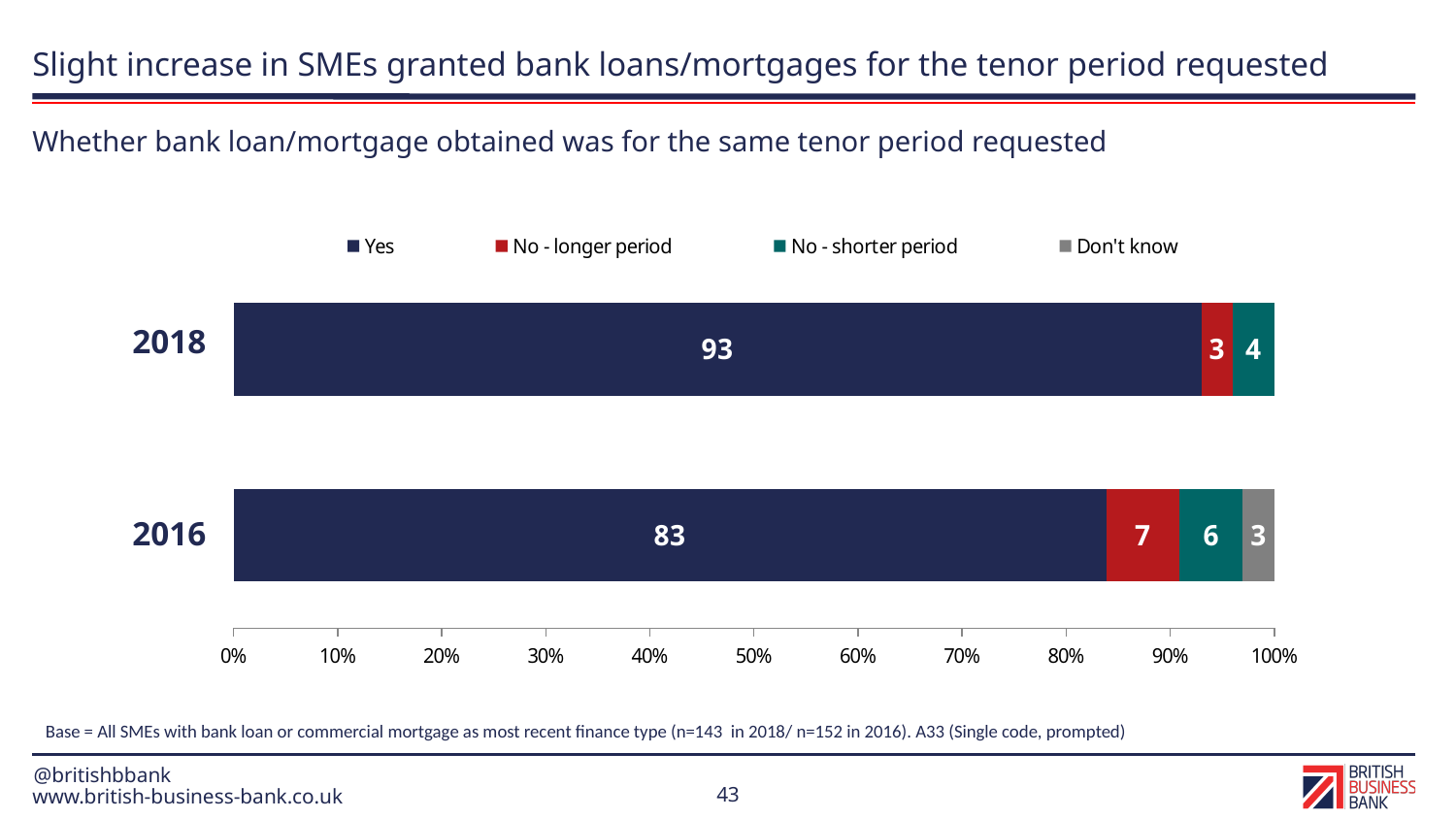
What percentage of SMEs in 2018 said the bank loan/mortgage obtained was for the same tenor period requested (Yes)? 93 What is the value for 'Don't know' in 2016? 3 What is the value for 'No - longer period' in 2016? 7 Is the 'Yes' value for 2016 greater or less than 80%? greater How many years are shown on the chart? 2 Which year has the larger 'No - shorter period' value, 2016 or 2018? 2016 What is the value for 'No - shorter period' in 2018? 4 How many series does the legend list? 4 What is the difference between the 'No - longer period' values for 2016 and 2018? 4 By how much did the 'Yes' value increase from 2016 to 2018? 10 What is the value for 'Yes' in 2016? 83 What type of chart is shown on the slide? Stacked bar chart